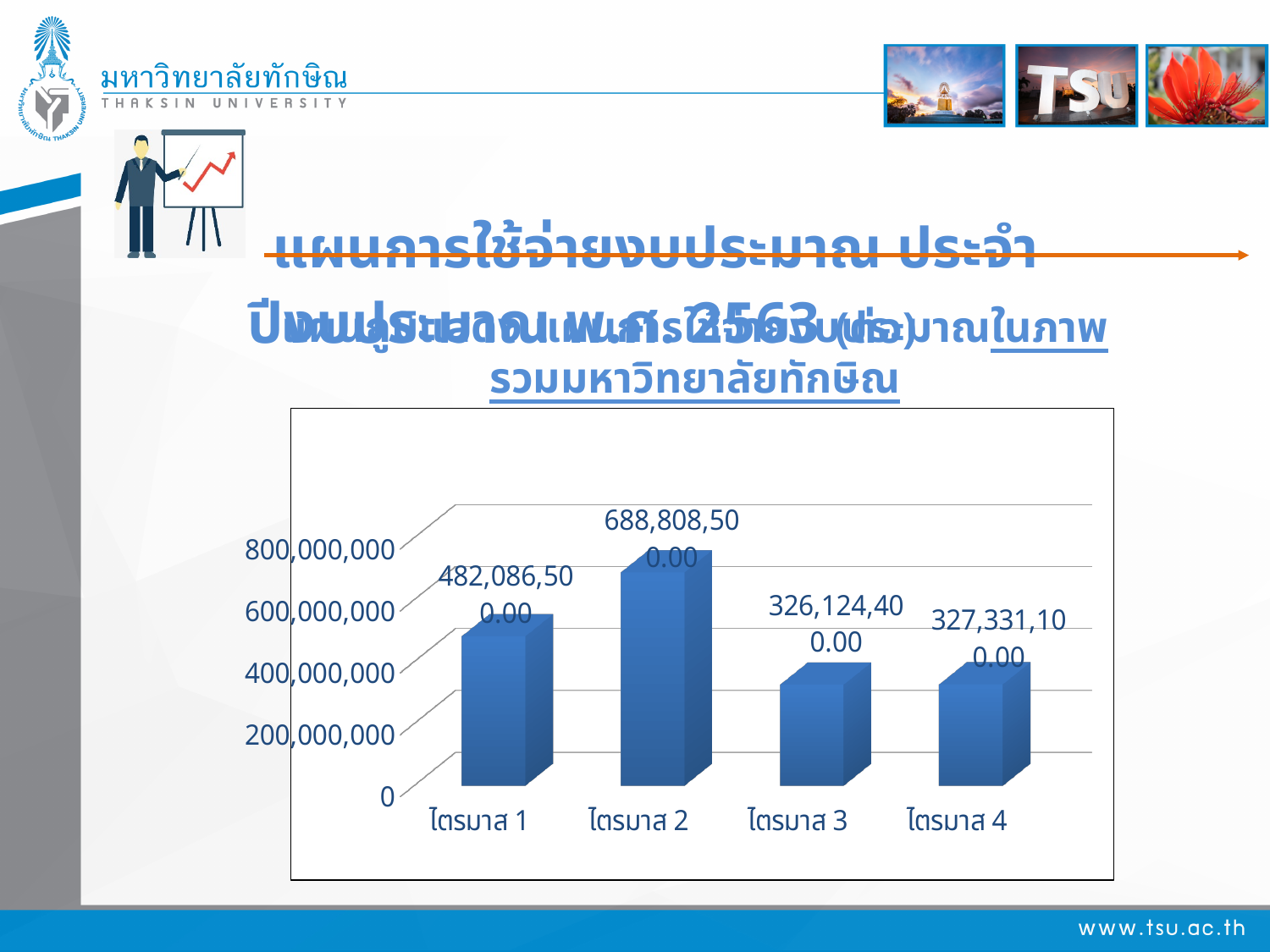
What is the value for ไตรมาส 3? 326,124,400.00 Is the value for ไตรมาส 3 greater or less than 400,000,000? less Which is larger, the value for ไตรมาส 1 or the value for ไตรมาส 3? ไตรมาส 1 Is the value for ไตรมาส 2 greater or less than 600,000,000? greater Which quarter has the lowest value? ไตรมาส 3 What is the value for ไตรมาส 2? 688,808,500.00 How many quarters are shown on the x axis? 4 What is the difference between the values for ไตรมาส 2 and ไตรมาส 1? 206,722,000.00 What is the value for ไตรมาส 4? 327,331,100.00 What kind of chart is shown on the slide? bar chart Which quarter has the highest value? ไตรมาส 2 What is the value for ไตรมาส 1? 482,086,500.00